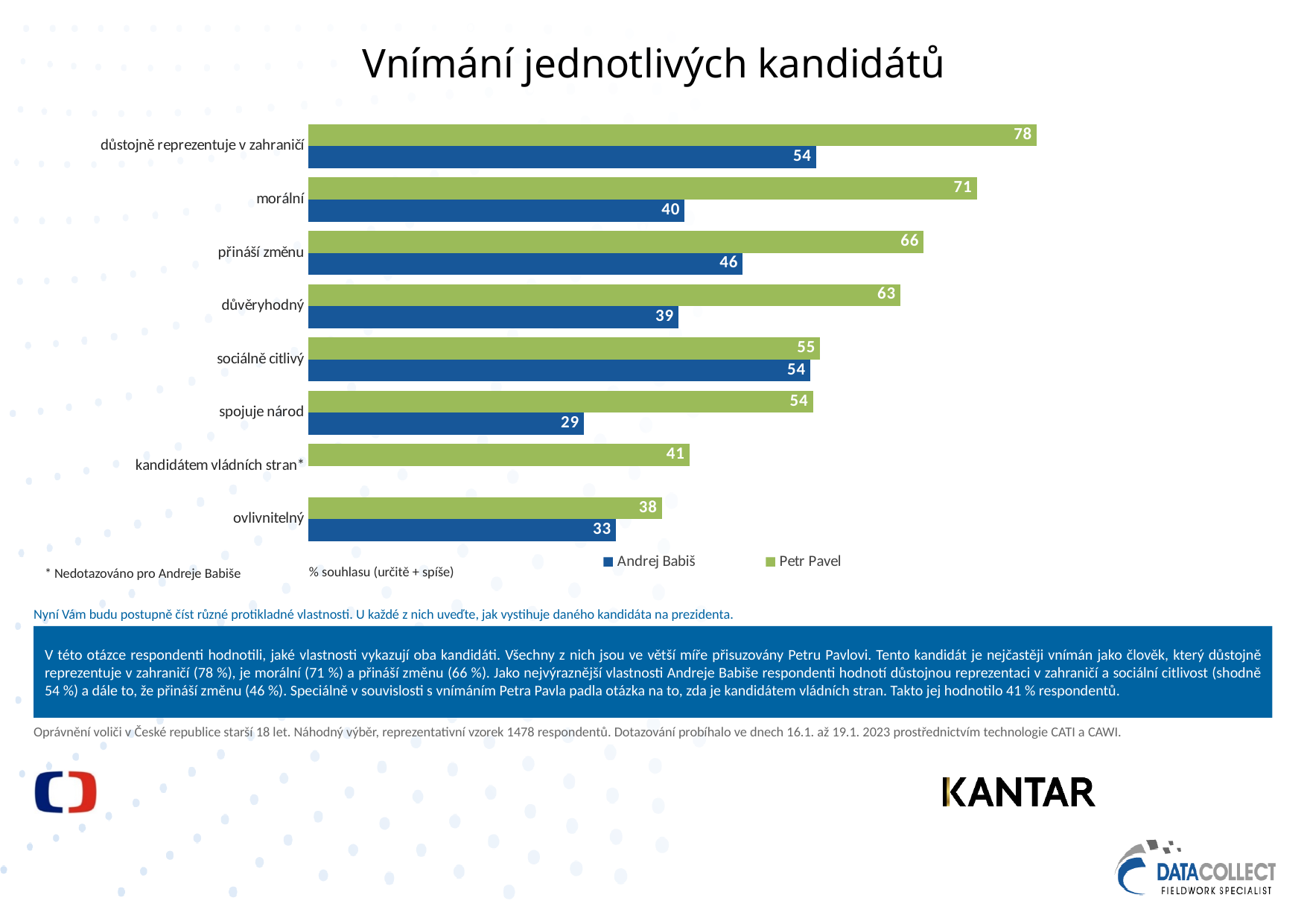
What kind of chart is shown on the slide? bar chart What is the value for Petr Pavel for "důstojně reprezentuje v zahraničí"? 78 How many categories are shown on the chart? 8 What is the difference between Petr Pavel and Andrej Babiš for "morální"? 31 Which category has a value only for Petr Pavel and not for Andrej Babiš? kandidátem vládních stran* What is the value for Andrej Babiš for "spojuje národ"? 29 Which category has the highest value for Petr Pavel? důstojně reprezentuje v zahraničí What is the difference between Petr Pavel and Andrej Babiš for "důvěryhodný"? 24 Which is larger: Petr Pavel's value for "přináší změnu" or Andrej Babiš's value for "přináší změnu"? Petr Pavel Which category has the lowest value for Andrej Babiš? spojuje národ How many series does the legend list? 2 What is the value for Andrej Babiš for "morální"? 40